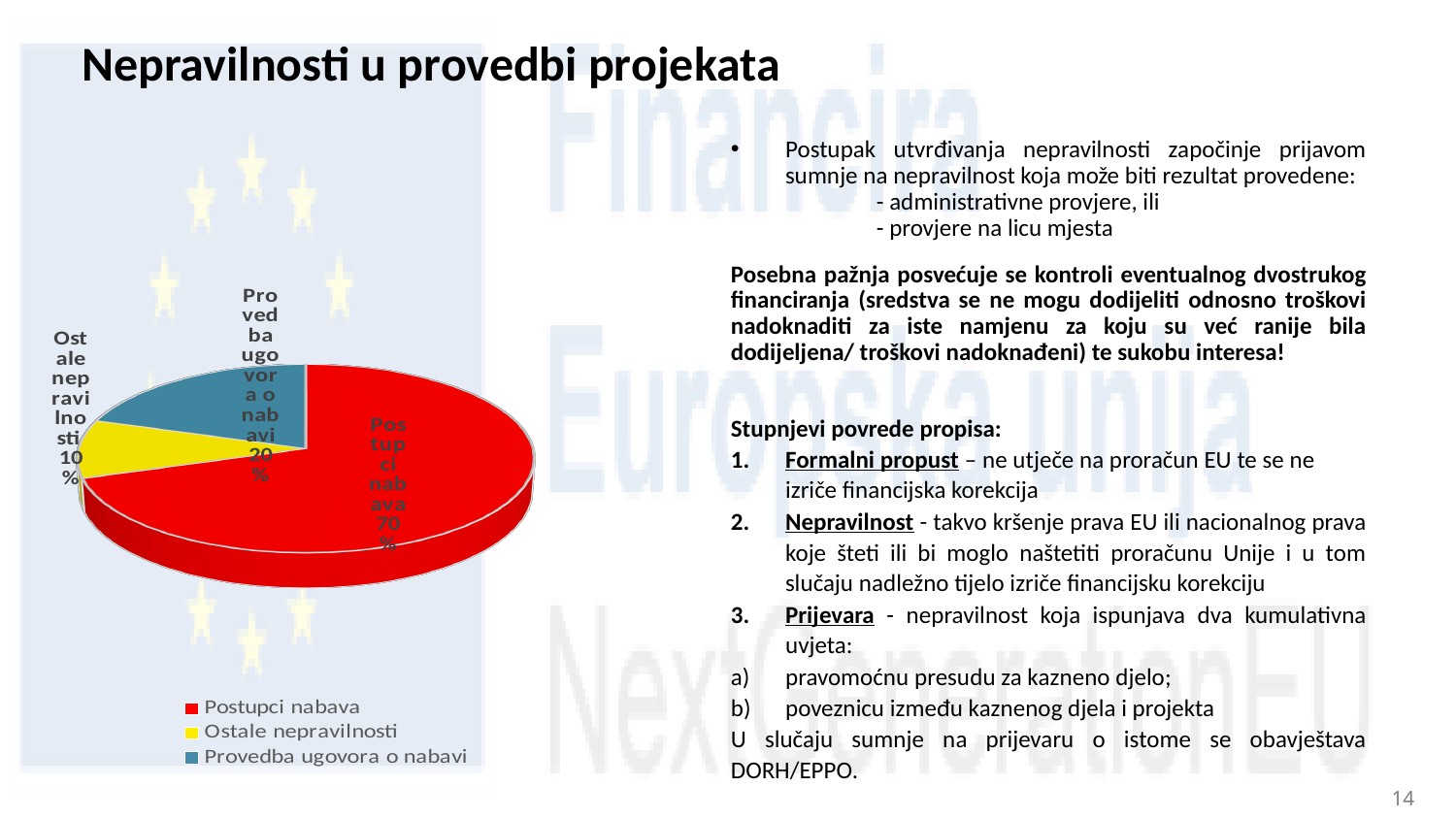
How many entries does the legend list? 3 What is the difference in percentage points between Postupci nabava and Provedba ugovora o nabavi? 50 What kind of chart is shown on the slide? pie chart What share of the pie does Provedba ugovora o nabavi have? 20% Which is larger, the slice for Provedba ugovora o nabavi or the slice for Ostale nepravilnosti? Provedba ugovora o nabavi How many categories does the pie chart show? 3 What share of the pie does Postupci nabava have? 70% Which category has the smallest slice of the pie? Ostale nepravilnosti What share of the pie does Ostale nepravilnosti have? 10% What colour is the slice for Postupci nabava? red What colour is the slice for Ostale nepravilnosti? yellow Which category has the largest slice of the pie? Postupci nabava